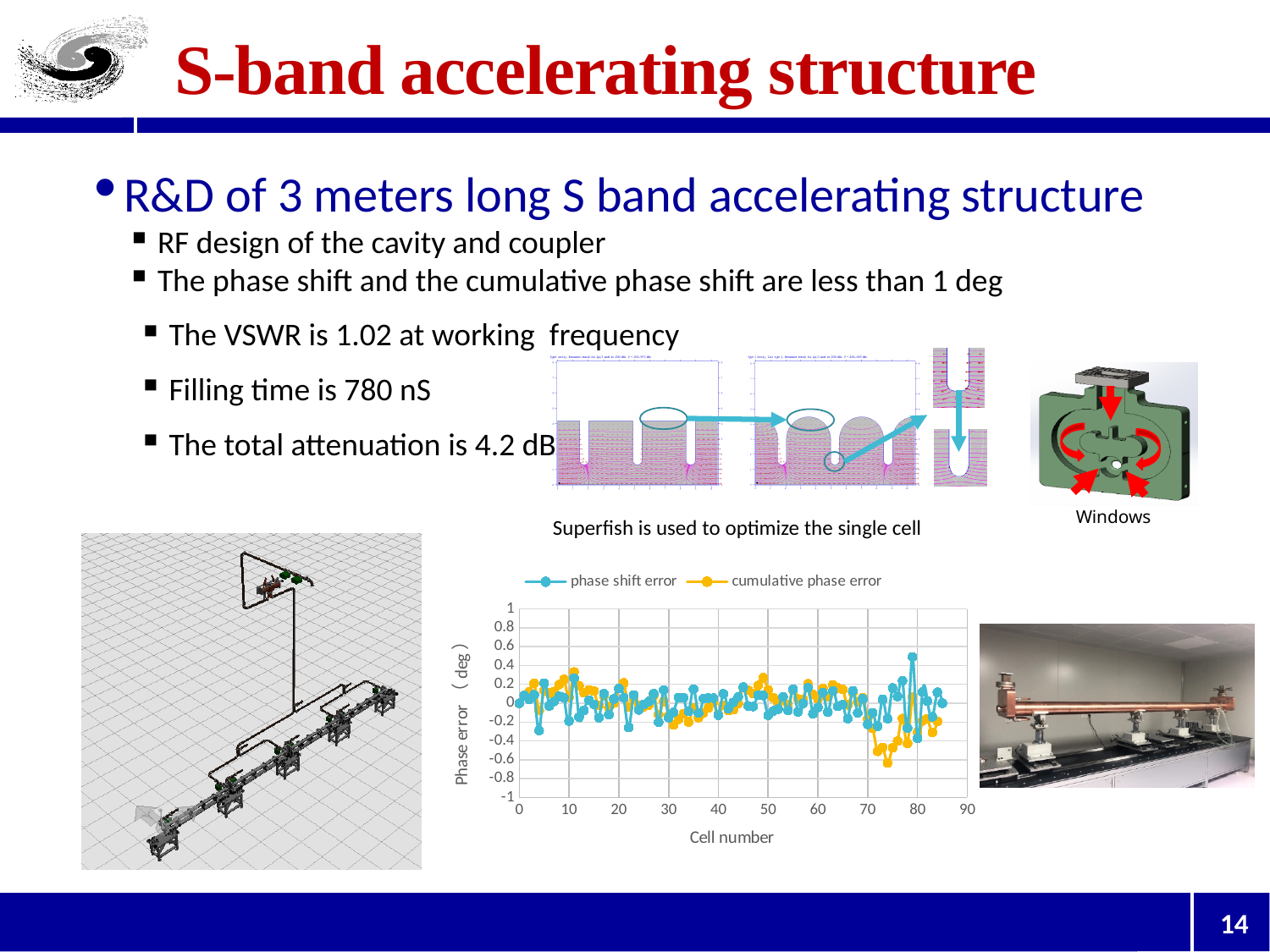
Is the highest value of the cumulative phase error series greater or less than 0.6? less How many series does the legend of the phase error chart list? 2 Is the lowest value of the cumulative phase error series greater or less than -1? greater Which series reaches the lowest value on the phase error chart, phase shift error or cumulative phase error? cumulative phase error Is the lowest value of the cumulative phase error series greater or less than -0.4? less What is the x-axis title of the phase error chart? Cell number What kind of chart is the phase error chart? line chart Which series reaches the highest value on the phase error chart, phase shift error or cumulative phase error? phase shift error What are the two series named in the legend of the phase error chart? phase shift error and cumulative phase error